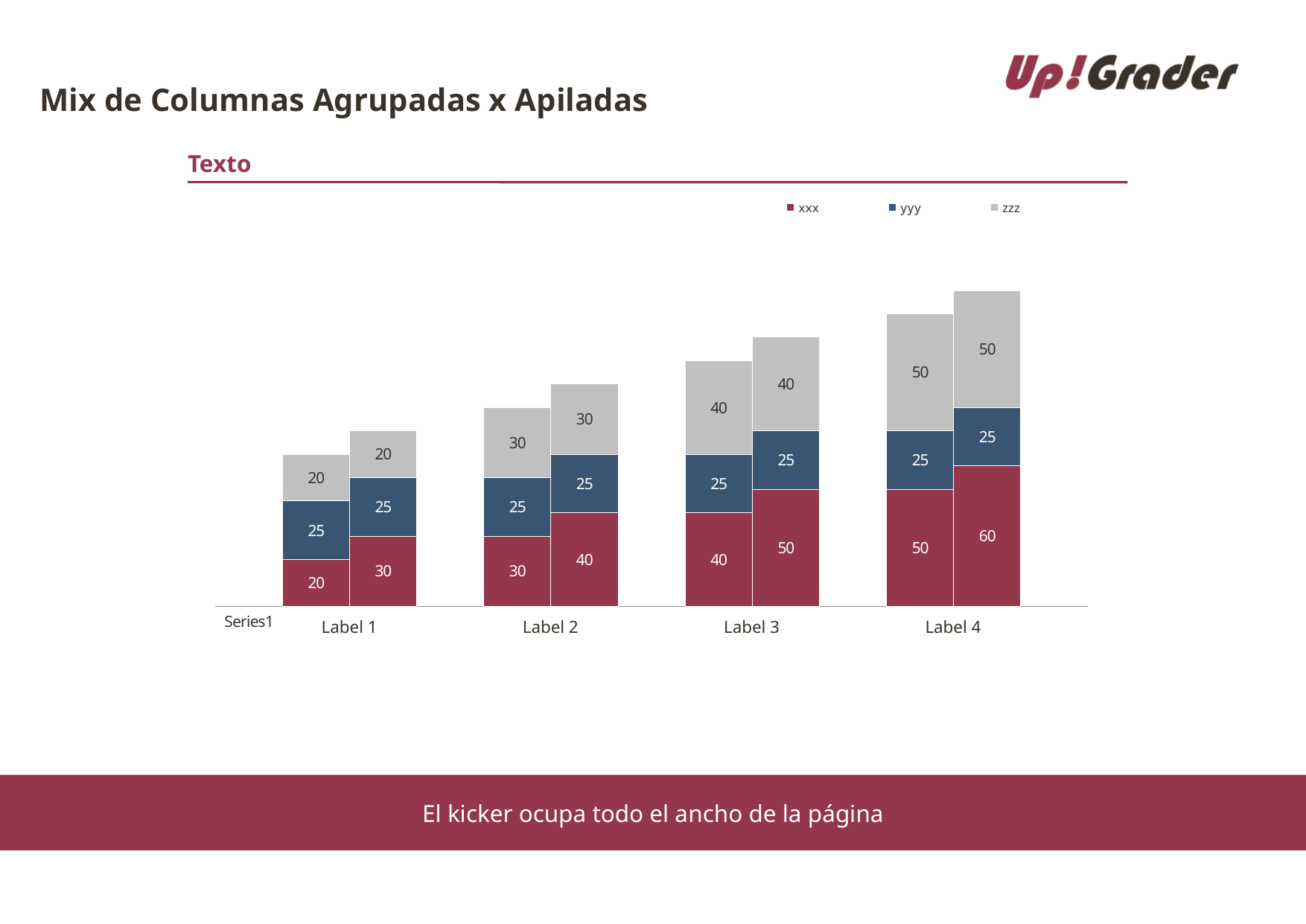
What is the total of the right stacked bar for Label 4? 135 What is the zzz value of the right stacked bar for Label 3? 40 What are the three series names in the legend? xxx, yyy, zzz What is the total of the left stacked bar for Label 2? 85 How many series does the legend list? 3 What kind of chart is shown on the slide? bar chart What is the xxx value of the right stacked bar for Label 4? 60 What is the difference between the xxx values of the right and left stacked bars for Label 3? 10 What is the xxx value of the left stacked bar for Label 1? 20 Which label has the shortest stacked bars? Label 1 Do the stacked bar totals rise or fall from Label 1 to Label 4? rise Which label has the tallest stacked bars? Label 4